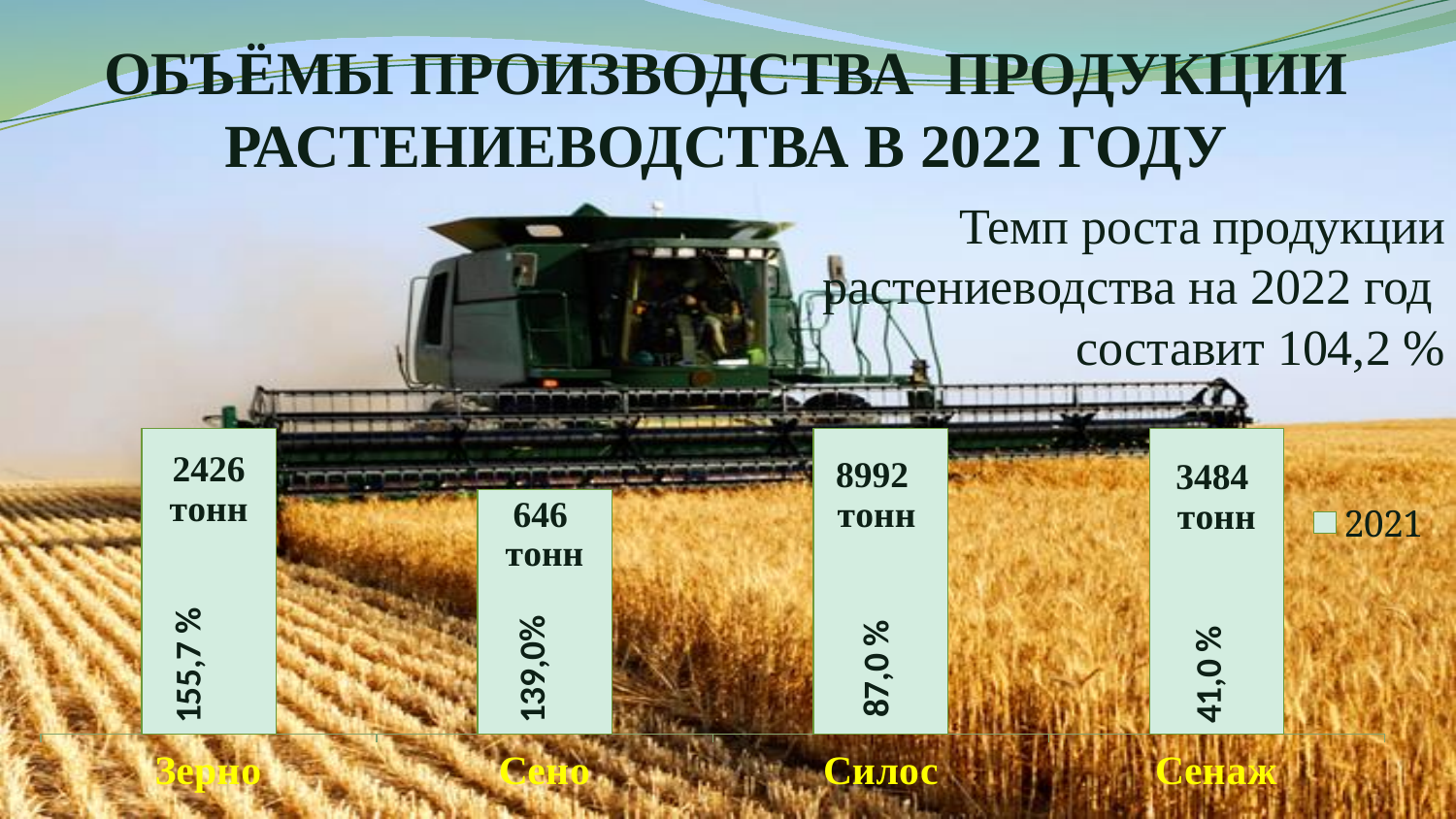
What kind of chart is shown on the slide? Bar chart What percentage is printed on the bar for Зерно? 155,7 % How many categories are shown on the x axis of the chart? 4 How many series does the chart legend list? 1 Which has a larger production volume in tonnes, Сенаж or Сено? Сенаж What is the difference in tonnes between the volumes for Силос and Зерно? 6566 тонн What is the production volume shown for Силос? 8992 тонн What is the production volume shown for Зерно? 2426 тонн Which category has the smallest production volume in tonnes according to the data labels? Сено Which category has the largest production volume in tonnes according to the data labels? Силос What is the production volume shown for Сено? 646 тонн What percentage is printed on the bar for Сенаж? 41,0 %